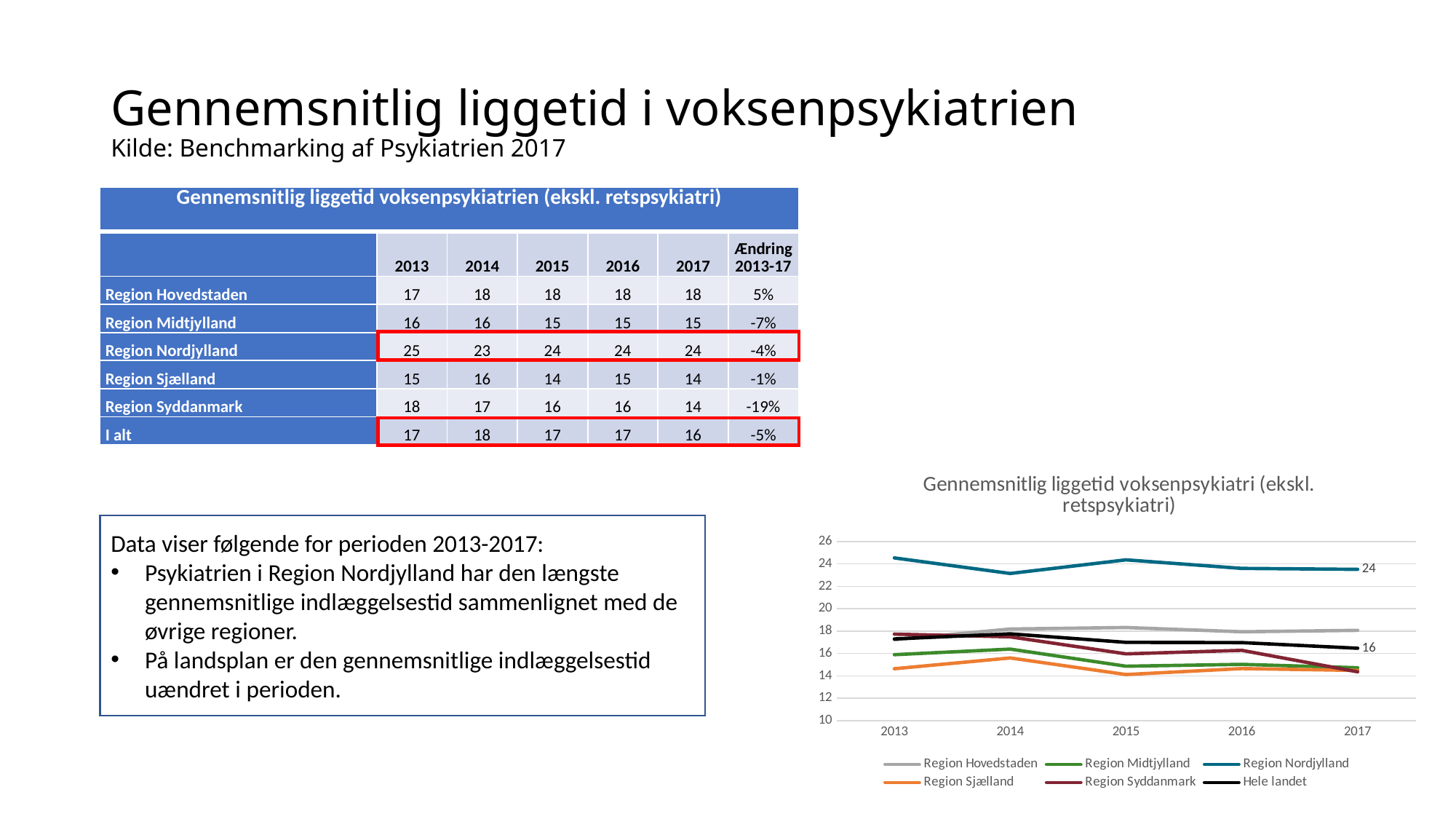
How many years are shown on the x axis of the chart? 5 Is the value for Region Sjælland in 2015 greater or less than 16? less What is the value labelled for Region Nordjylland in 2017 on the chart? 24 Which series has the highest values across all years in the chart? Region Nordjylland How many series does the chart legend list? 6 What kind of chart is shown on the slide? line chart What is the difference between the 2017 values labelled for Region Nordjylland and Hele landet? 8 Does the Region Syddanmark line rise or fall from 2013 to 2017? fall Which is larger in 2013: Region Nordjylland or Region Hovedstaden? Region Nordjylland What is the title of the chart? Gennemsnitlig liggetid voksenpsykiatri (ekskl. retspsykiatri) Is the value for Region Nordjylland in 2014 greater or less than 22? greater What is the value labelled for Hele landet in 2017 on the chart? 16